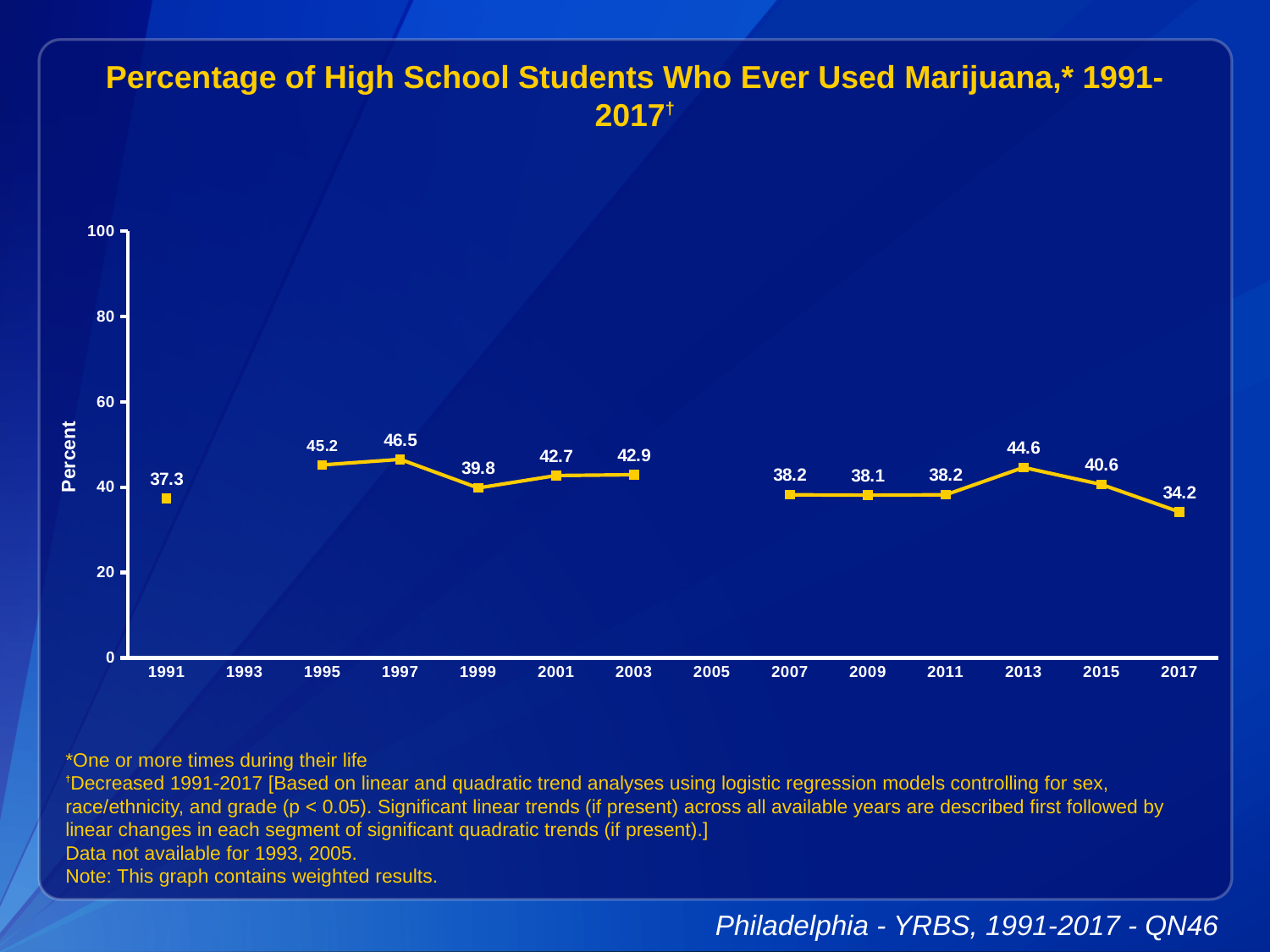
Which year has a higher value, 2013 or 2015? 2013 Did the percentage rise or fall from 2013 to 2017? Fall Which year has the highest percentage of students who ever used marijuana? 1997 What percentage of high school students had ever used marijuana in 1991? 37.3 Is the value for 1995 greater or less than 40? greater What is the difference between the 1997 value and the 2017 value? 12.3 What is the value plotted for 2017? 34.2 What is the label on the y axis? Percent What is the value plotted for 2013? 44.6 How many years have data points plotted on the chart? 12 What kind of chart is shown on the slide? Line chart Which year has the lowest percentage of students who ever used marijuana? 2017